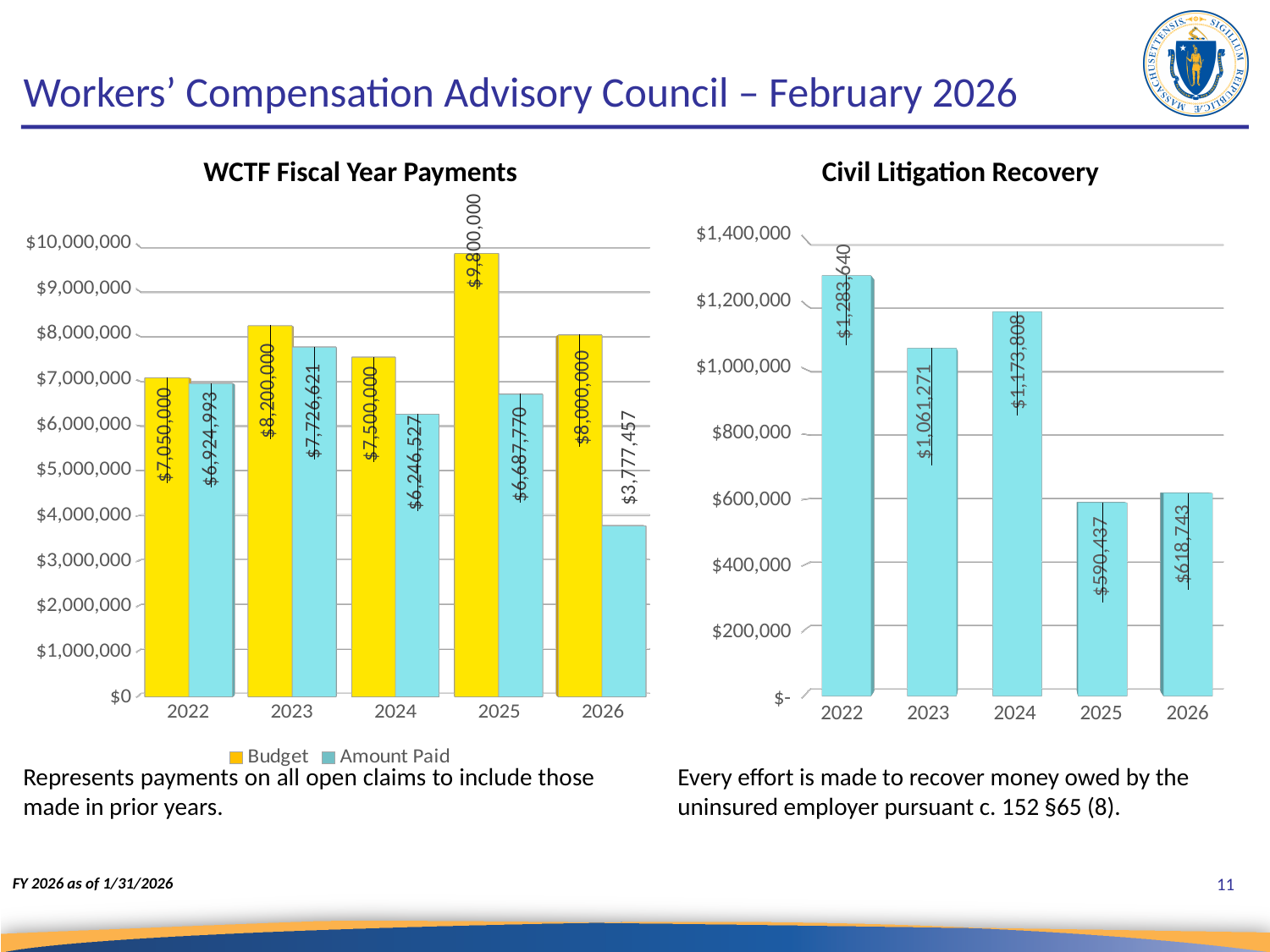
In the WCTF Fiscal Year Payments chart, which year has the larger Amount Paid, 2023 or 2024? 2023 In the Civil Litigation Recovery chart, which year has the highest recovery? 2022 In the WCTF Fiscal Year Payments chart, what is the difference between the Budget and the Amount Paid for 2024? $1,253,473 In the WCTF Fiscal Year Payments chart, what is the Amount Paid for 2026? $3,777,457 How many series does the legend of the WCTF Fiscal Year Payments chart list? 2 In the Civil Litigation Recovery chart, what is the value for 2023? $1,061,271 In the WCTF Fiscal Year Payments chart, which year has the highest Amount Paid? 2023 In the Civil Litigation Recovery chart, which year has the lowest recovery? 2025 In the Civil Litigation Recovery chart, how much larger is the 2022 value than the 2023 value? $222,369 How many years are shown in the Civil Litigation Recovery chart? 5 In the WCTF Fiscal Year Payments chart, what is the Budget value for 2025? $9,800,000 In the WCTF Fiscal Year Payments chart, is the Amount Paid for 2026 greater or less than $4,000,000? less